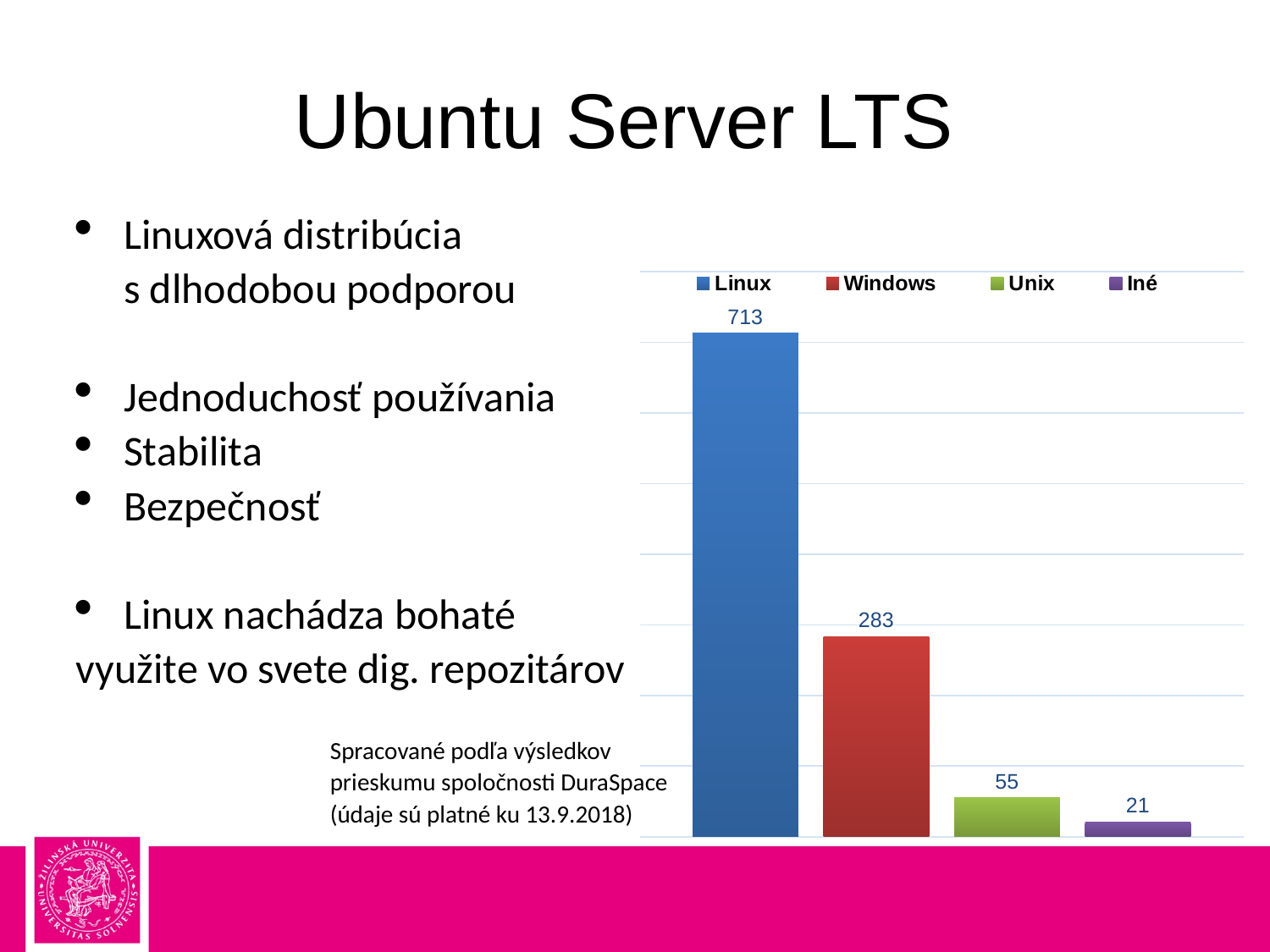
What is the difference between the values for Linux and Windows? 430 Which series has the lowest value? Iné How many series does the legend list? 4 What is the difference between the values for Unix and Iné? 34 What is the value for Windows? 283 What colour is the bar for Windows? red What is the value for Linux? 713 What kind of chart is shown on the slide? bar chart Which is larger, the value for Windows or the value for Unix? Windows What is the value for Iné? 21 What is the value for Unix? 55 Which series has the highest value? Linux